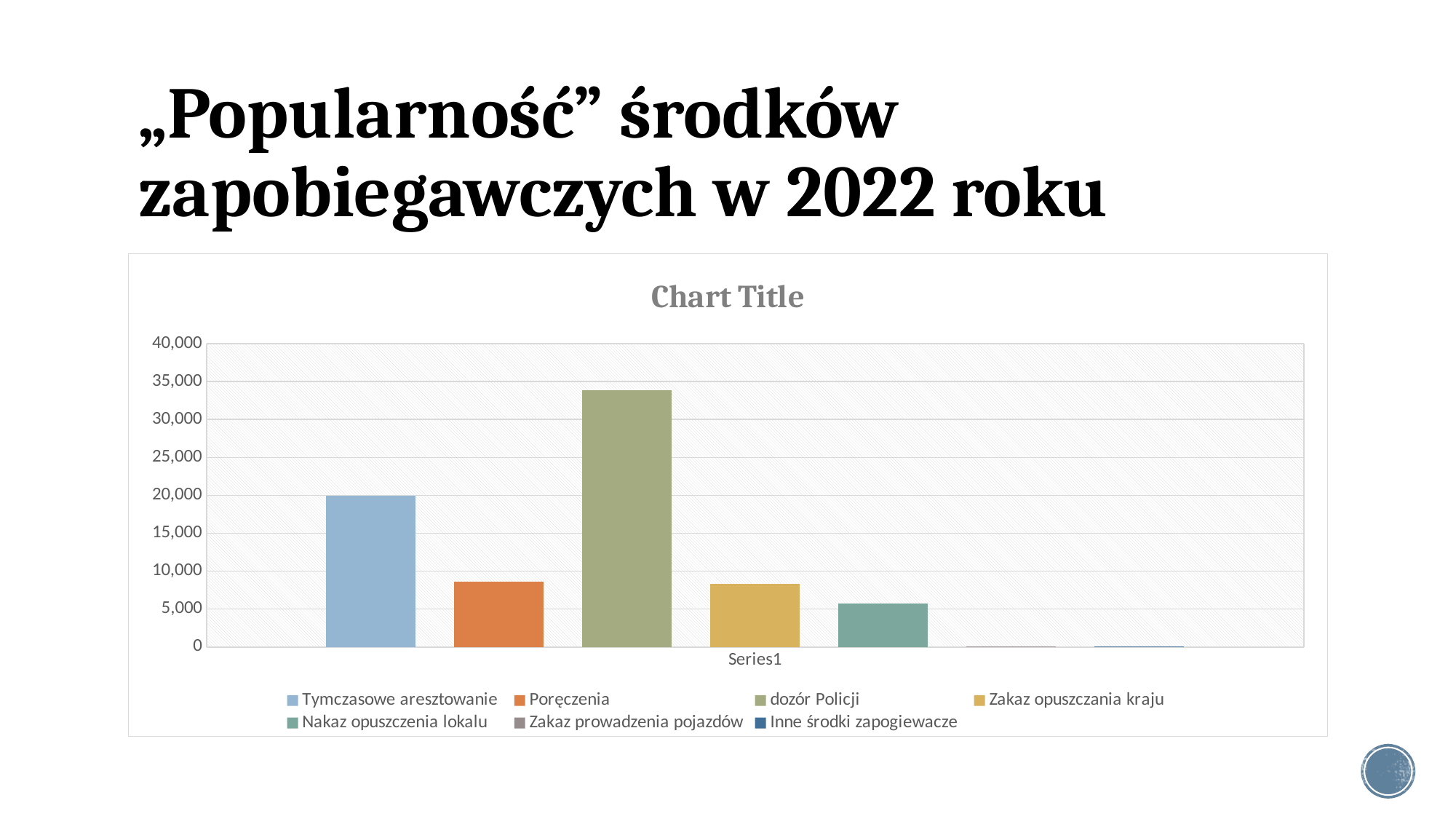
Is the value for Nakaz opuszczenia lokalu greater or less than 10,000? less What is the title shown above the chart? Chart Title Which is larger, the value for dozór Policji or the value for Tymczasowe aresztowanie? dozór Policji Which is larger, the value for Tymczasowe aresztowanie or the value for Poręczenia? Tymczasowe aresztowanie Which is larger, the value for Zakaz opuszczania kraju or the value for Nakaz opuszczenia lokalu? Zakaz opuszczania kraju How many series does the legend list? 7 Is the value for Poręczenia greater or less than 5,000? greater Which series has the highest bar? dozór Policji What label appears on the x axis below the bars? Series1 What kind of chart is shown on the slide? bar chart Is the value for Tymczasowe aresztowanie greater or less than 25,000? less